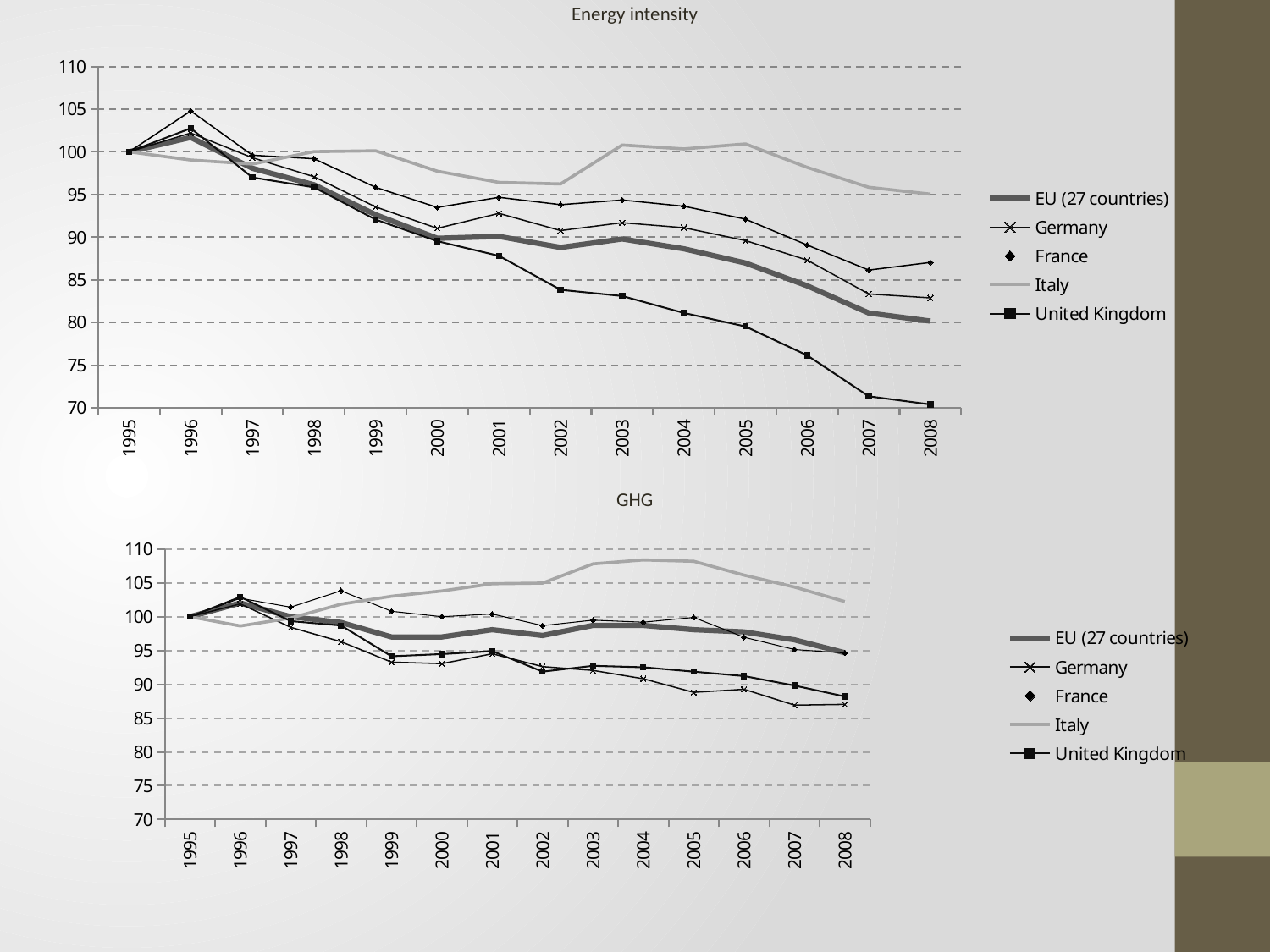
In the Energy intensity chart, does the United Kingdom series rise or fall from 1995 to 2008? fall In the GHG chart, which is larger in 2007, the value for France or the value for Germany? France In the GHG chart, which series has the highest value in 2004? Italy In the Energy intensity chart, which series has the lowest value in 2008? United Kingdom In the Energy intensity chart, what is the value for EU (27 countries) in 1995? 100 What kind of chart is the Energy intensity chart? line chart In the Energy intensity chart, is the value for Germany in 2008 greater or less than 85? less In the Energy intensity chart, is the value for United Kingdom in 2006 greater or less than 75? greater In the GHG chart, is the value for Italy in 2008 greater or less than 100? greater In the Energy intensity chart, which series has the highest value in 2008? Italy How many years are shown on the x axis of the Energy intensity chart? 14 How many series does the legend of the GHG chart list? 5